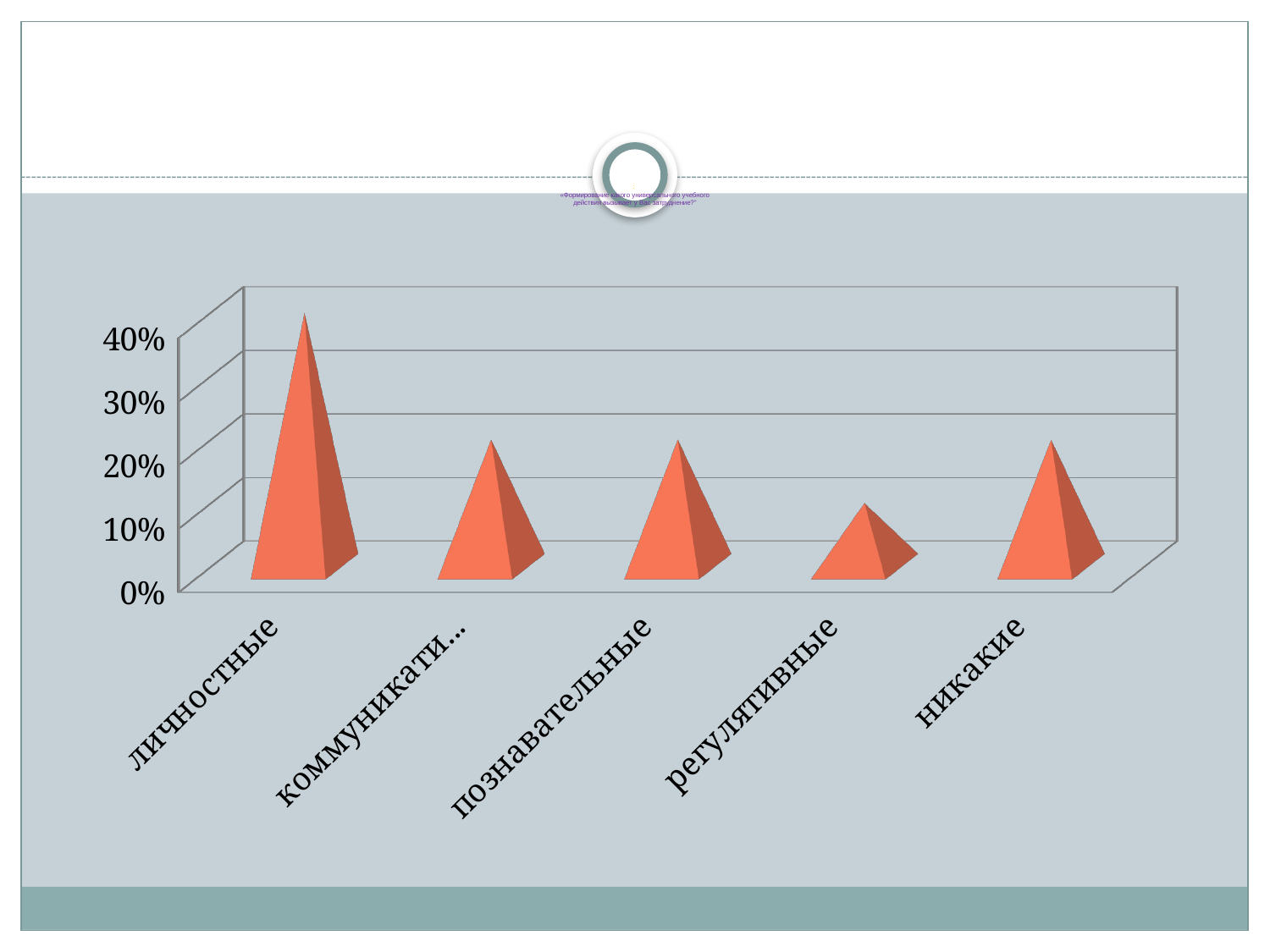
Which category has the lowest value in the chart? регулятивные What kind of chart is shown on the slide? bar chart Is the value for познавательные greater or less than 30%? less Which is larger, the value for познавательные or the value for регулятивные? познавательные Is the value for личностные greater or less than 30%? greater What is the highest value labelled on the vertical axis of the chart? 40% How many categories are shown on the x axis of the chart? 5 Is the value for никакие greater or less than 10%? greater What colour are the bars in the chart? orange Which category has the highest value in the chart? личностные Which is larger, the value for личностные or the value for регулятивные? личностные